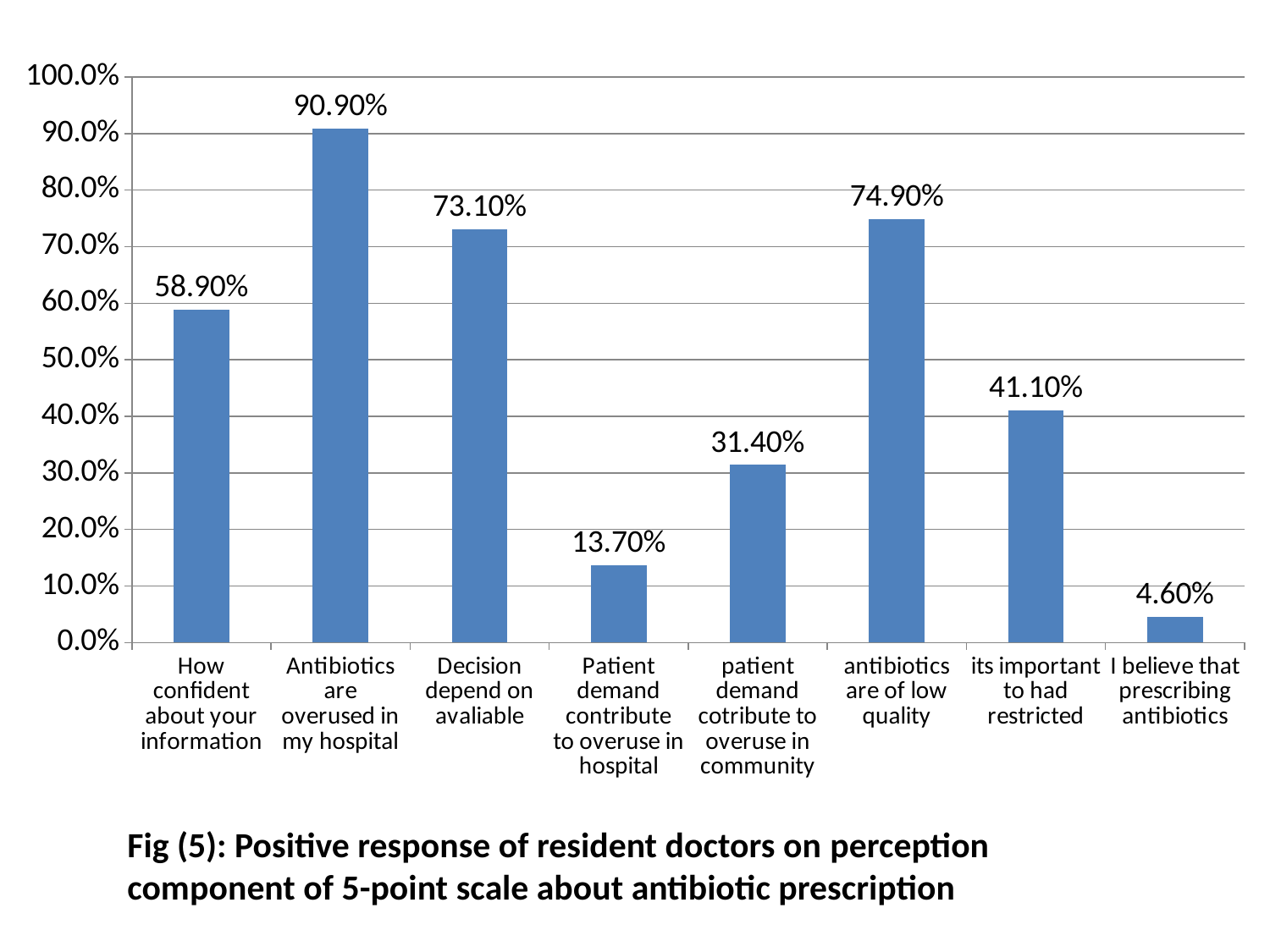
Which category has the lowest value? I believe that prescribing antibiotics Which is larger: "How confident about your information" or "patient demand cotribute to overuse in community"? How confident about your information What is the difference between the highest and lowest values? 86.30% What is the figure number given in the caption below the chart? Fig (5) Which category has the highest value? Antibiotics are overused in my hospital What is the value for "antibiotics are of low quality"? 74.90% What is the value for "I believe that prescribing antibiotics"? 4.60% What is the value for "Antibiotics are overused in my hospital"? 90.90% Is the value for "Patient demand contribute to overuse in hospital" greater or less than 20.0%? less How many categories are shown on the x axis? 8 What kind of chart is shown on the slide? bar chart What is the difference between "Decision depend on avaliable" and "its important to had restricted"? 32.00%